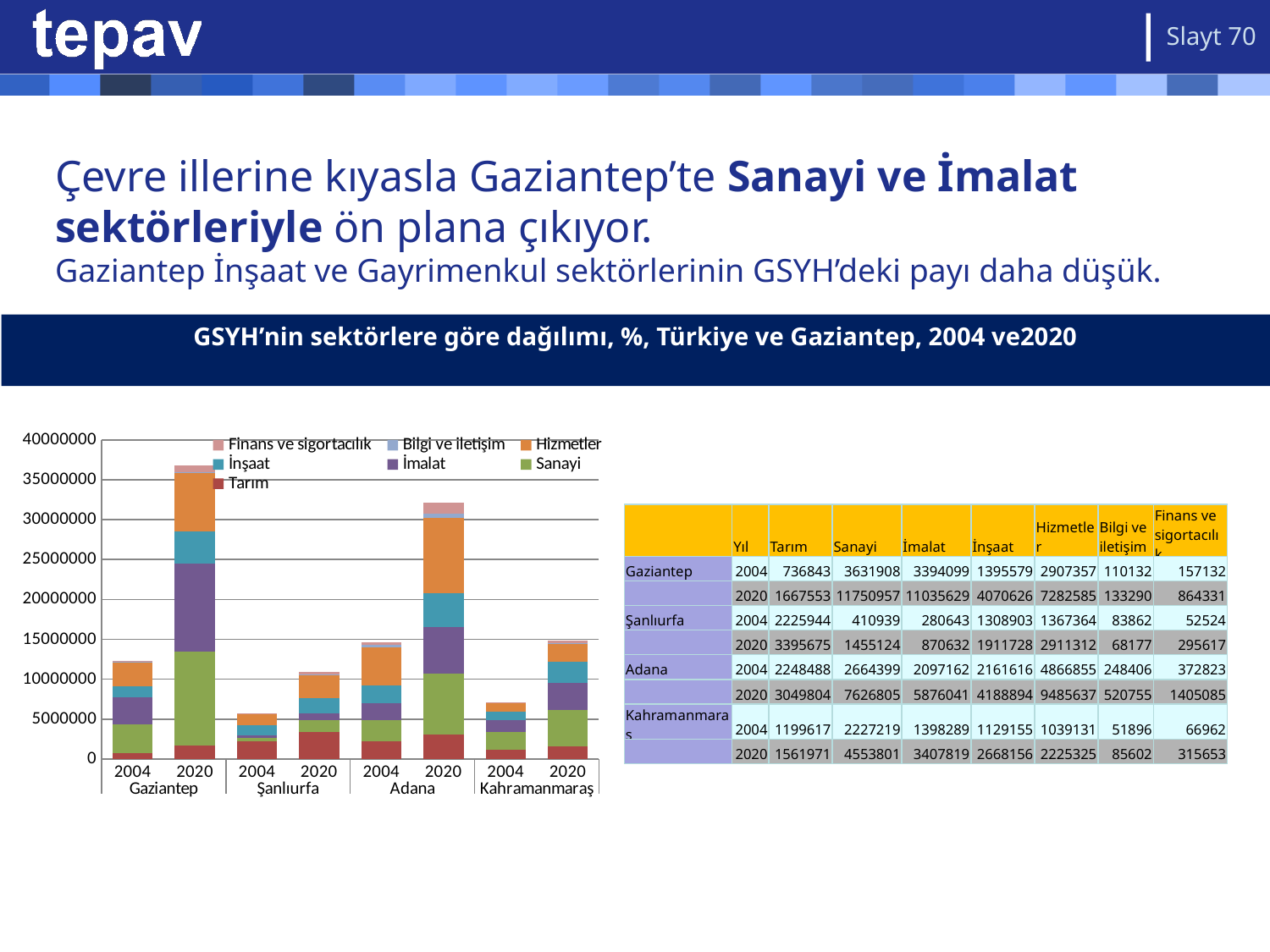
How many stacked bars are plotted in the chart? 8 Which bar is the tallest in the chart? Gaziantep 2020 Using the table values, what is the difference between Gaziantep's Sanayi value in 2020 and in 2004? 8119049 What kind of chart is shown on the slide? Stacked bar chart According to the table, what is the Sanayi value for Gaziantep in 2020? 11750957 According to the table, what is the Hizmetler value for Adana in 2004? 4866855 Is the total of the Adana 2020 bar greater or less than 25000000? greater Which bar is taller: Gaziantep 2020 or Adana 2020? Gaziantep 2020 What colour represents the Sanayi series in the chart? Green Is the total of the Gaziantep 2020 bar greater or less than 35000000? greater Which bar is the shortest in the chart? Şanlıurfa 2004 How many series does the chart legend list? 7